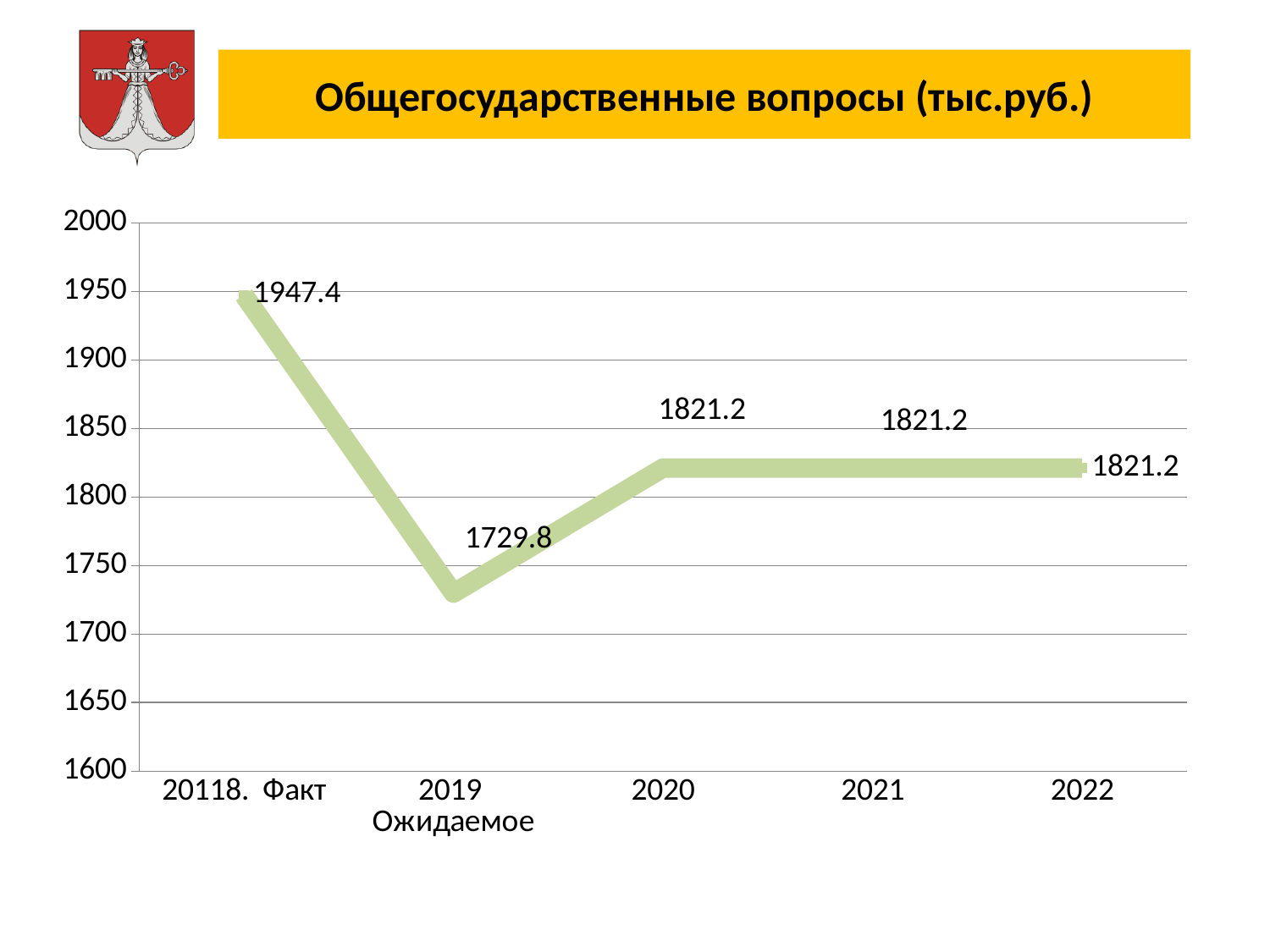
Which point on the x axis has the highest value? The first point (Факт) Which is larger, the value for 2019 Ожидаемое or the value for 2021? 2021 Which point on the x axis has the lowest value? 2019 Ожидаемое What is the value for the first point on the x axis (Факт)? 1947.4 What kind of chart is shown on the slide? Line chart What is the value for 2022? 1821.2 What is the title of the chart? Общегосударственные вопросы (тыс.руб.) What is the difference between the first point (Факт) and 2019 Ожидаемое? 217.6 What is the difference between the 2020 value and the 2019 Ожидаемое value? 91.4 What is the value for 2019 Ожидаемое? 1729.8 What is the value for 2020? 1821.2 How many data points are plotted on the line? 5